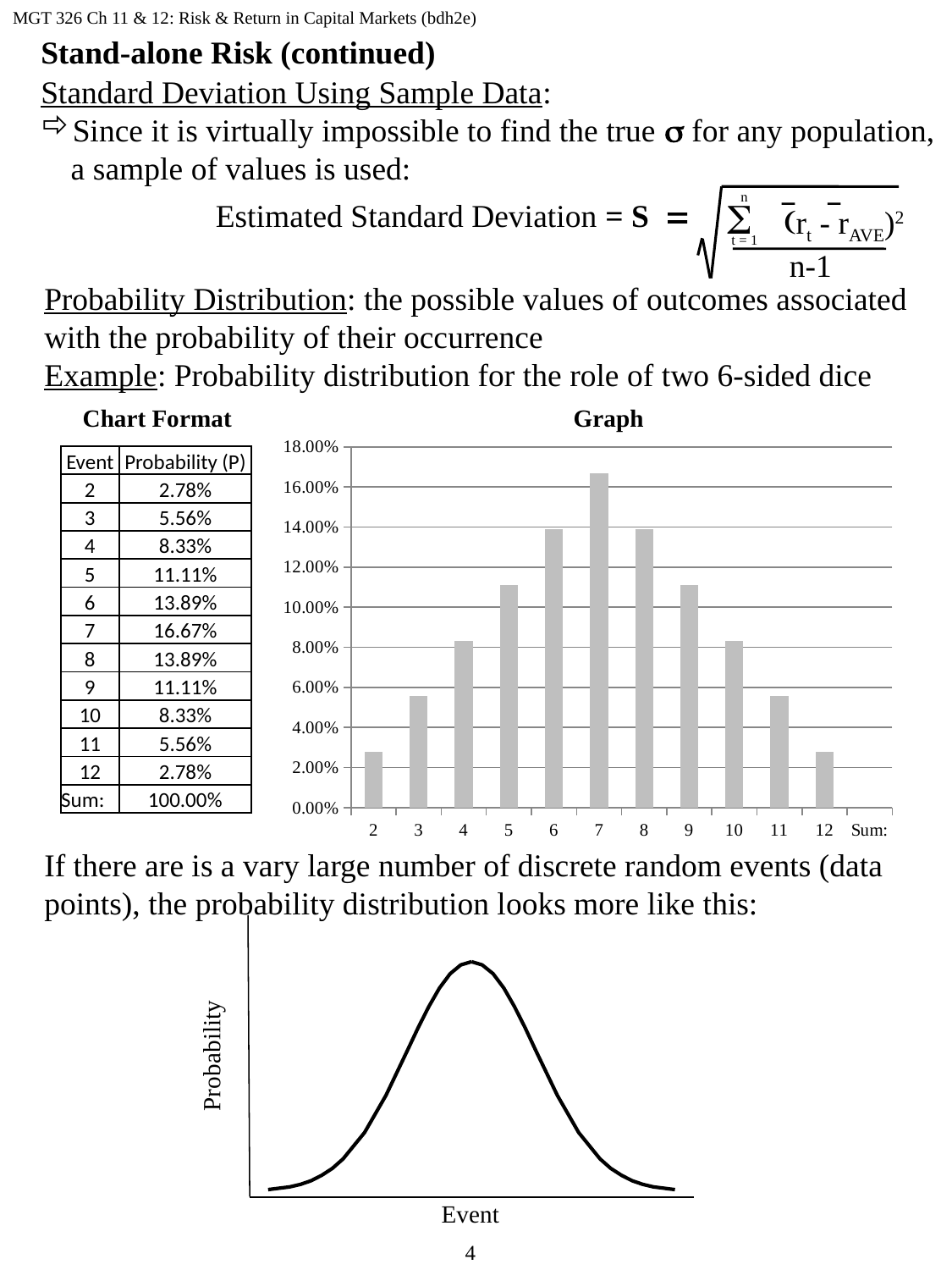
What is the highest tick value shown on the vertical axis of the chart titled "Graph"? 18.00% In the chart titled "Graph", do the values rise or fall from event 7 to event 12? fall In the chart titled "Graph", is the value for event 6 greater or less than 12.00%? greater What kind of chart is the one titled "Graph"? bar chart In the chart titled "Graph", which event has the highest probability? 7 In the chart titled "Graph", is the value for event 10 greater or less than 10.00%? less In the chart titled "Graph", which is larger, the value for event 5 or the value for event 4? event 5 In the chart titled "Graph", what is the probability for event 4? 8.33% In the chart titled "Graph", what is the difference between the probability for event 7 and the probability for event 6? 2.78% In the chart titled "Graph", what is the probability for event 7? 16.67% In the chart titled "Graph", how many bars are plotted? 11 In the chart titled "Graph", what is the probability for event 11? 5.56%